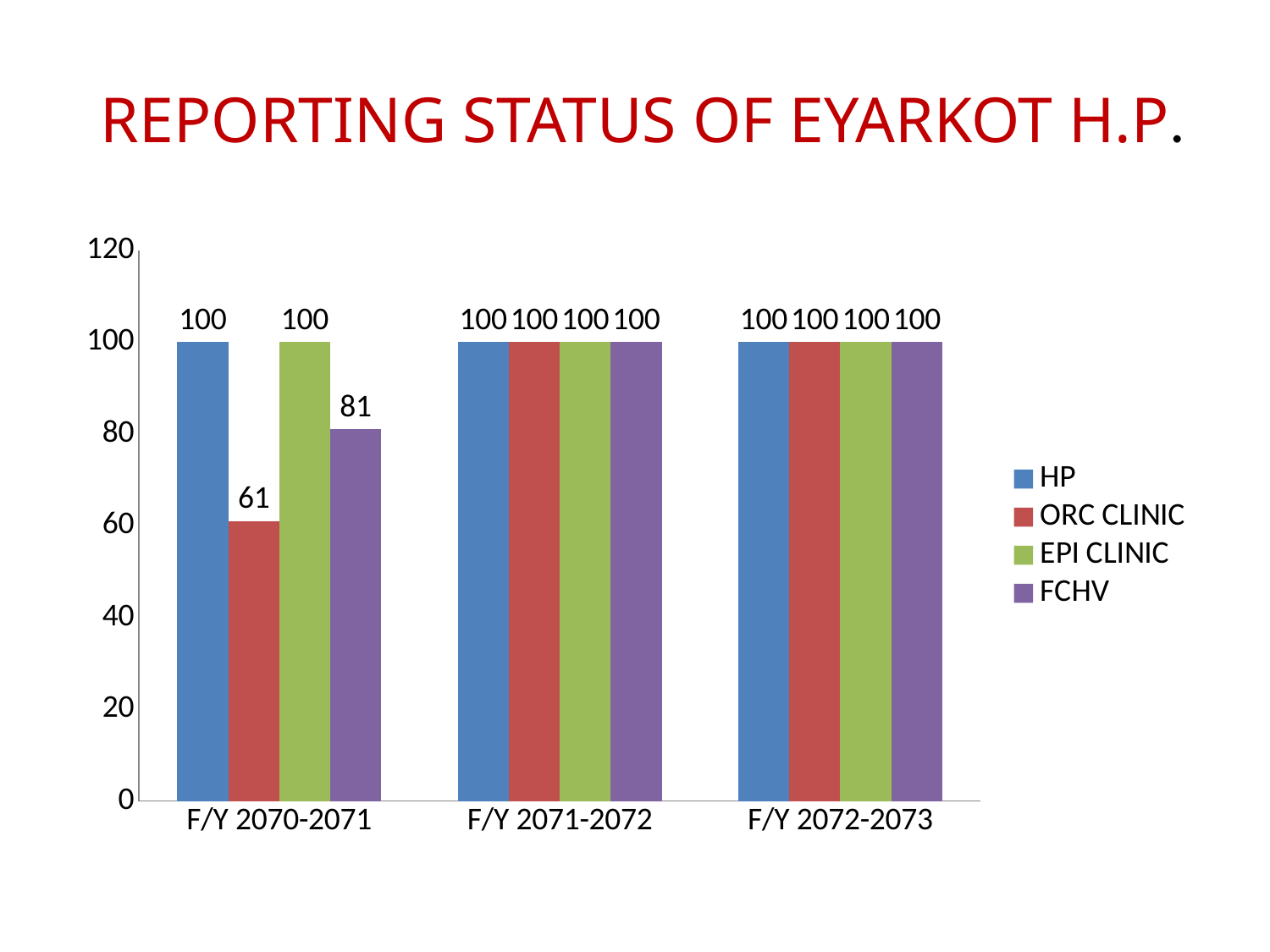
How many fiscal year categories are shown on the x axis? 3 Which series has the lowest value in F/Y 2070-2071? ORC CLINIC What is the difference between the HP and FCHV values in F/Y 2070-2071? 19 How many series does the legend list? 4 What is the value for ORC CLINIC in F/Y 2070-2071? 61 What is the title of the slide? REPORTING STATUS OF EYARKOT H.P. What is the value for FCHV in F/Y 2070-2071? 81 What kind of chart is shown on the slide? Bar chart What is the value for EPI CLINIC in F/Y 2072-2073? 100 What is the difference between the FCHV and ORC CLINIC values in F/Y 2070-2071? 20 Which is larger in F/Y 2070-2071, the value for EPI CLINIC or the value for ORC CLINIC? EPI CLINIC What is the value for HP in F/Y 2071-2072? 100